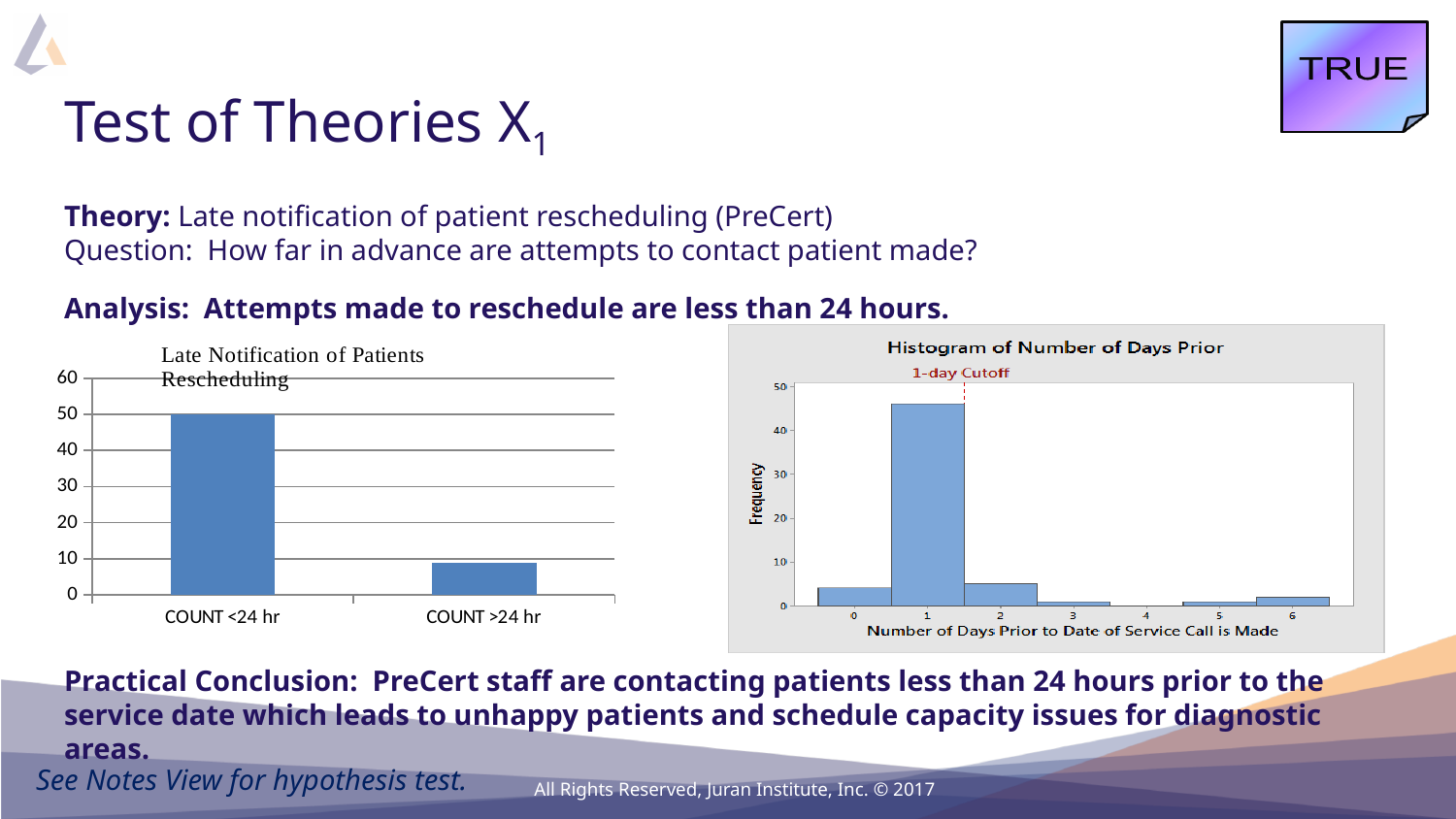
On the right chart, 'Histogram of Number of Days Prior', which number of days has the highest frequency? 1 How many day values are shown on the x axis of the right chart, 'Histogram of Number of Days Prior'? 7 On the left chart titled 'Late Notification of Patients Rescheduling', which category has the lowest value? COUNT >24 hr On the left chart titled 'Late Notification of Patients Rescheduling', what is the value for COUNT <24 hr? 50 On the right chart, 'Histogram of Number of Days Prior', is the frequency for 0 days greater or less than 10? less On the right chart, 'Histogram of Number of Days Prior', which has the higher frequency: 1 day or 2 days? 1 day On the left chart titled 'Late Notification of Patients Rescheduling', is the value for COUNT >24 hr greater or less than 10? less What is the label of the dashed vertical line on the right chart, 'Histogram of Number of Days Prior'? 1-day Cutoff On the left chart titled 'Late Notification of Patients Rescheduling', which category has the higher value? COUNT <24 hr How many categories are shown on the left chart titled 'Late Notification of Patients Rescheduling'? 2 On the right chart, 'Histogram of Number of Days Prior', is the frequency for 1 day greater or less than 40? greater What kind of chart is the left chart titled 'Late Notification of Patients Rescheduling'? bar chart